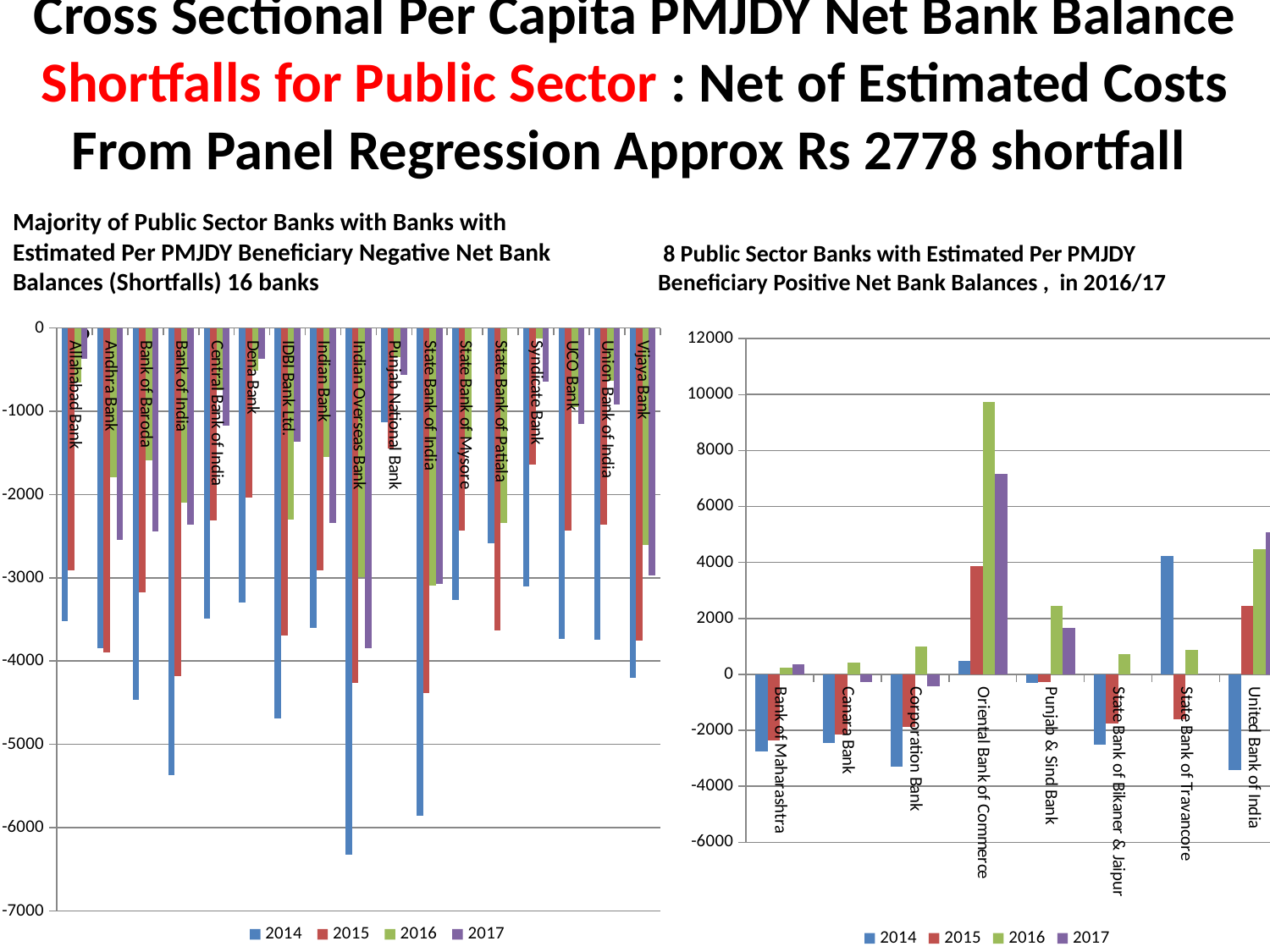
What kind of chart is the chart on the left of the slide? bar chart How many series does the legend of the right-hand chart list? 4 On the left-hand chart, is the 2014 value for State Bank of India greater or less than -5000? less On the left-hand chart, which is larger: the 2014 value for State Bank of India or the 2014 value for Indian Overseas Bank? State Bank of India On the right-hand chart, is the 2014 value for Bank of Maharashtra greater or less than -2000? less What are the legend entries of the left-hand chart? 2014, 2015, 2016, 2017 How many banks (categories) are shown on the right-hand chart? 8 On the right-hand chart, is the 2016 value for Oriental Bank of Commerce greater or less than 8000? greater On the right-hand chart, which bank has the highest bar? Oriental Bank of Commerce On the left-hand chart, which bank has the lowest (most negative) bar? Indian Overseas Bank